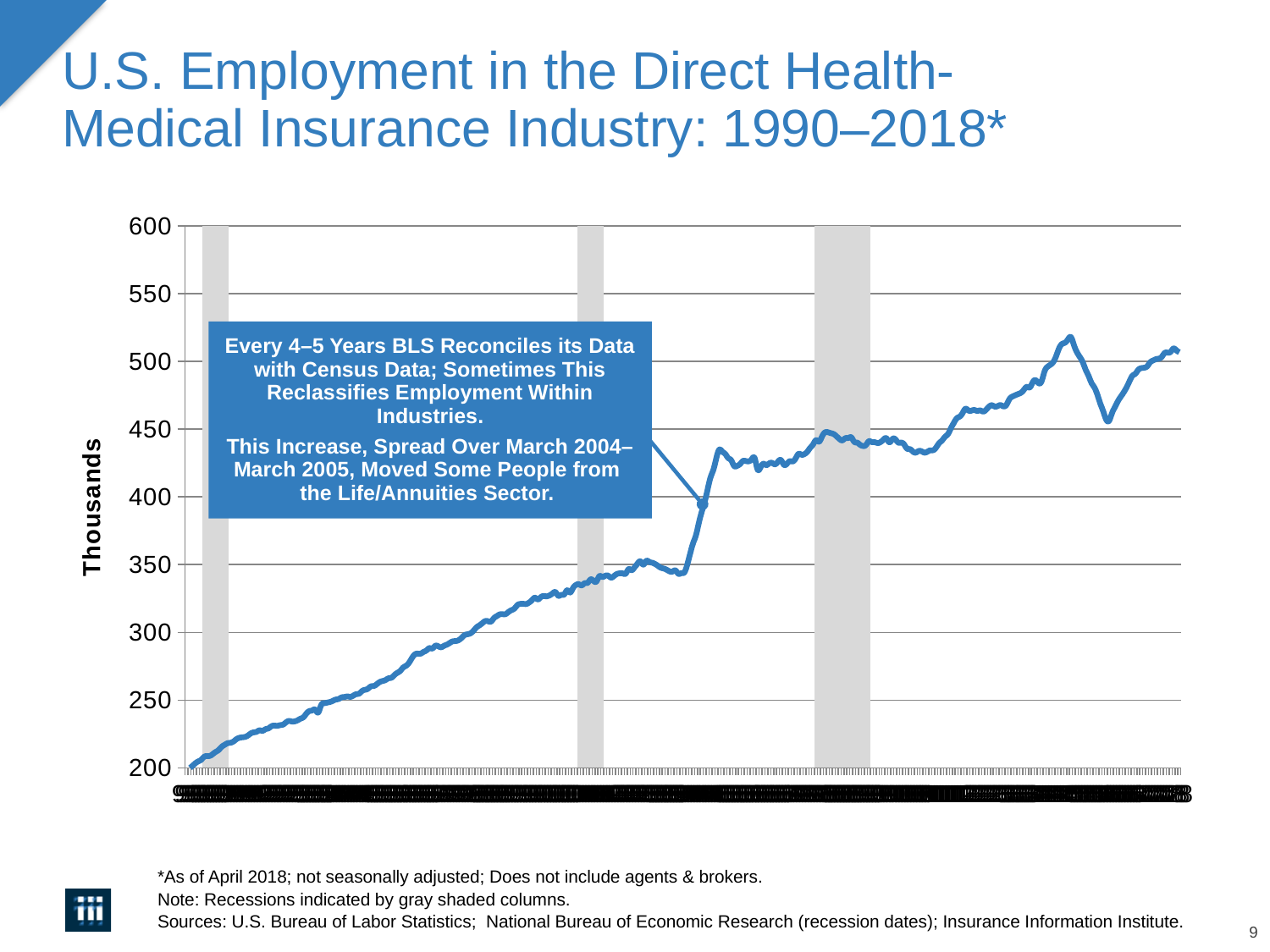
Is the lowest point on the line greater or less than 250? less Is the highest point on the line greater or less than 550? less What kind of chart is shown on the slide? line chart What is the label on the vertical axis? Thousands Overall, do the values rise or fall from the left of the x axis to the right? rise Is the value at the end of the line (2018) greater or less than 450? greater How many gray shaded recession columns are shown on the chart? 3